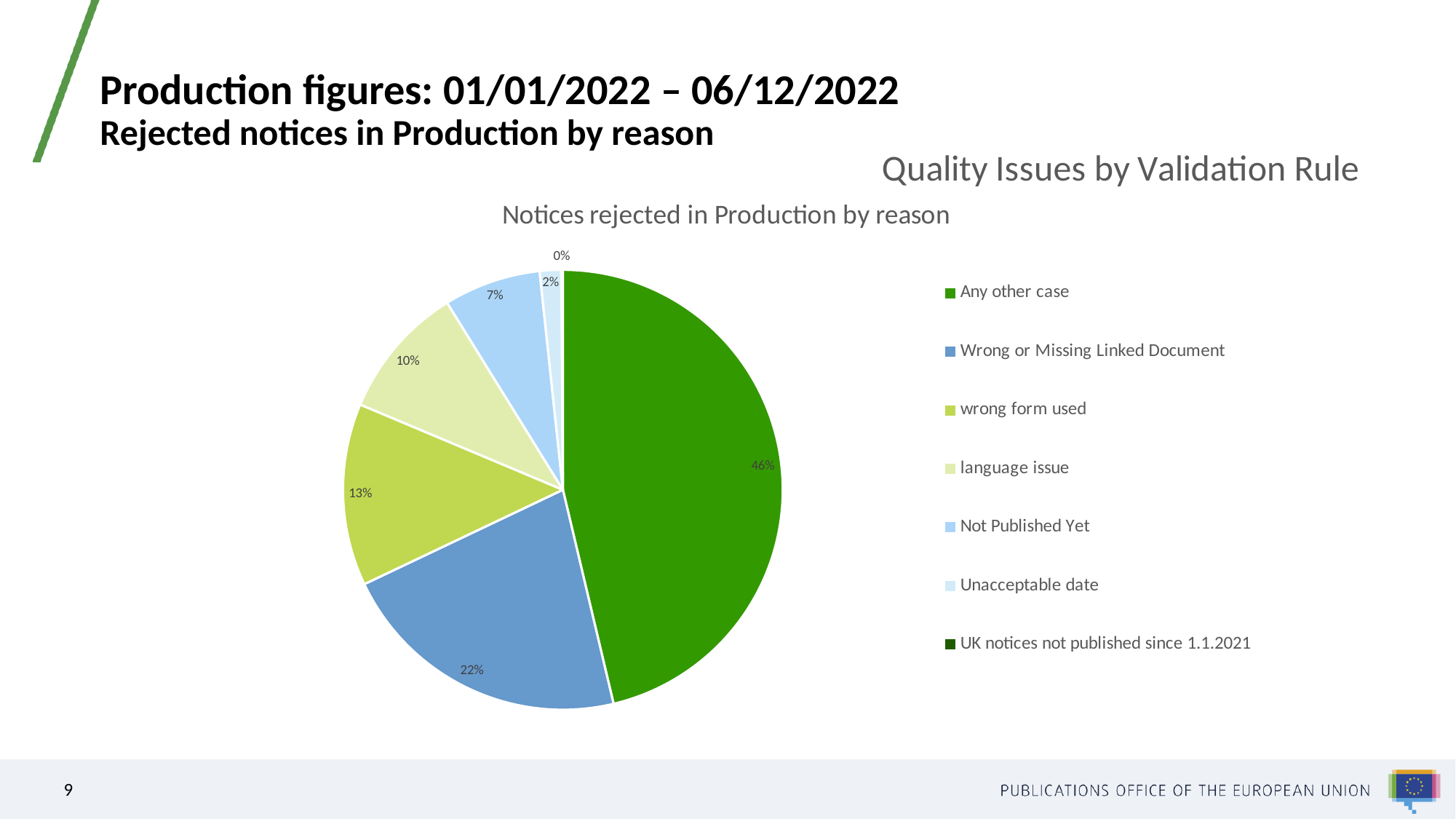
Which reason accounts for the smallest share of rejected notices? UK notices not published since 1.1.2021 What is the difference in percentage points between the 'Any other case' share and the 'Wrong or Missing Linked Document' share? 24 percentage points Which reason accounts for the largest share of rejected notices? Any other case What share of rejected notices is labelled for 'Wrong or Missing Linked Document'? 22% What type of chart is shown on the slide? pie chart What share of rejected notices is labelled for 'Unacceptable date'? 2% What share of rejected notices is labelled for 'Not Published Yet'? 7% What is the title of the chart? Notices rejected in Production by reason How many categories does the legend of the pie chart list? 7